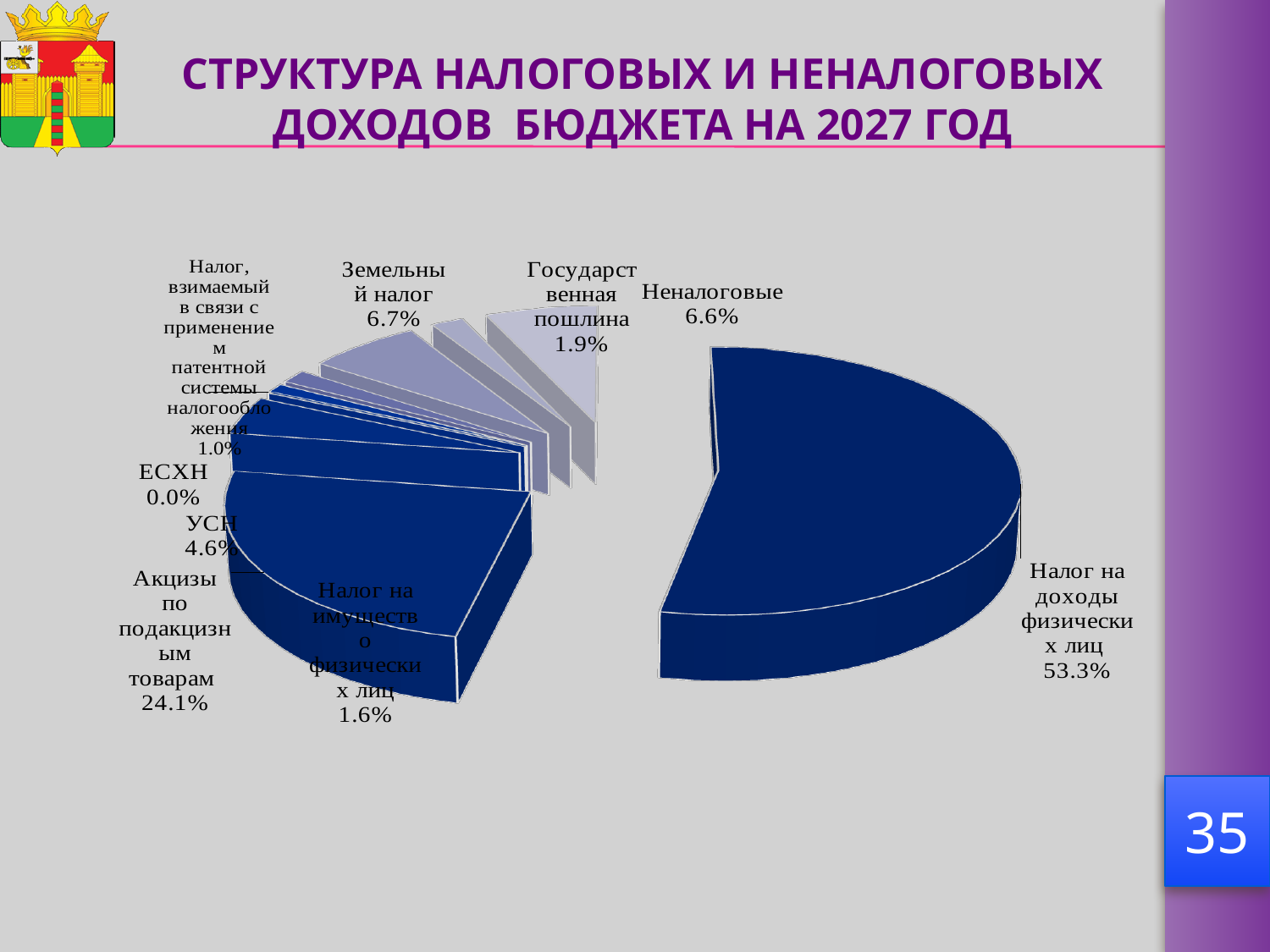
What percentage is shown for "Земельный налог"? 6.7% What share of the budget revenue does "Налог на доходы физических лиц" account for? 53.3% What is the value shown for "Акцизы по подакцизным товарам"? 24.1% Which category has the smallest share of the pie? ЕСХН Which is larger: the share of "УСН" or the share of "Налог на имущество физических лиц"? УСН What kind of chart is shown on the slide? Pie chart What is the difference between the shares of "Налог на доходы физических лиц" and "Акцизы по подакцизным товарам"? 29.2% What year does the chart title refer to? 2027 What is the value for "Неналоговые" revenues? 6.6% How many categories are shown in the pie chart? 9 What percentage is shown for "Государственная пошлина"? 1.9% Which category has the largest share of the pie? Налог на доходы физических лиц